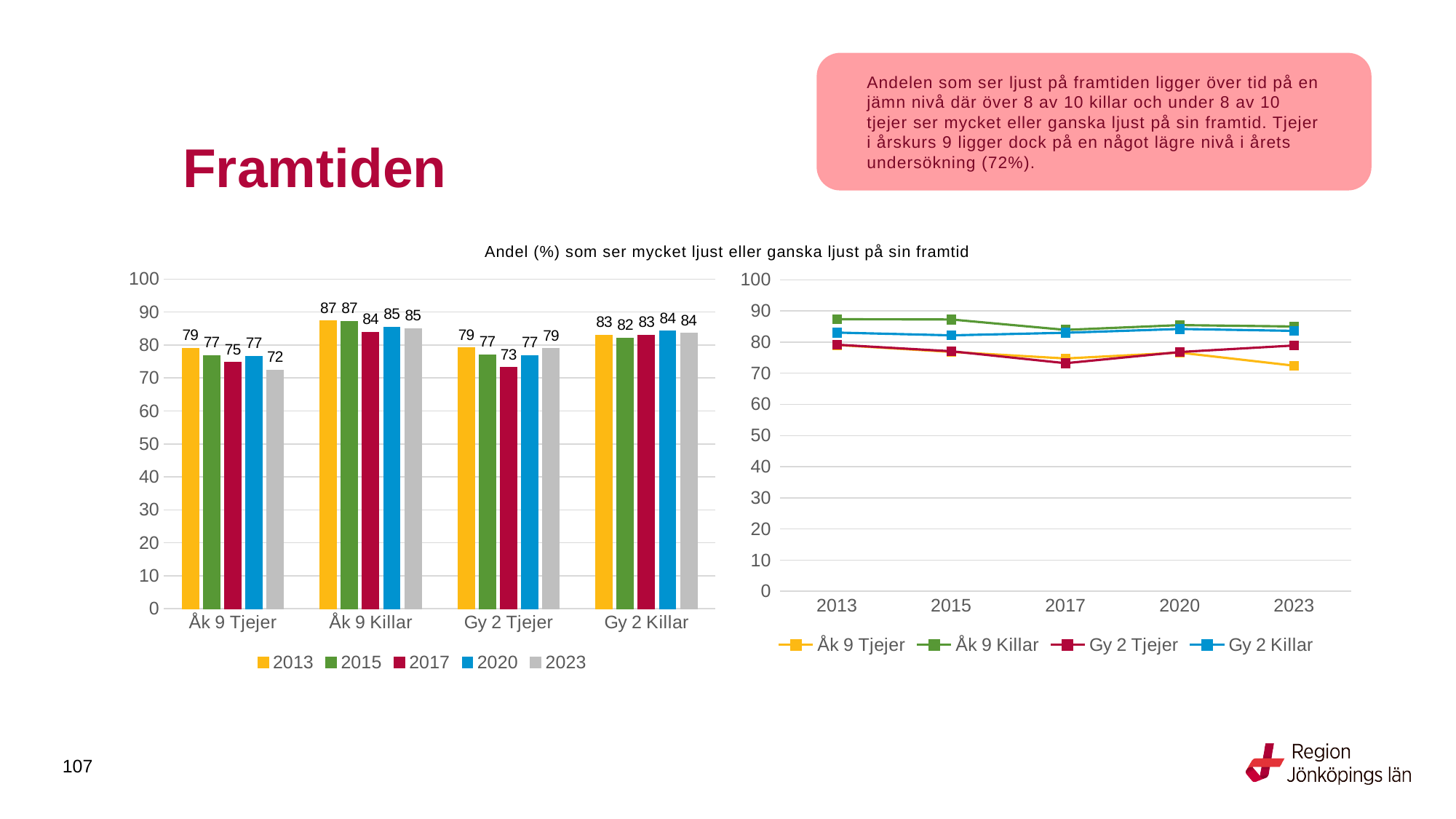
In the bar chart on the left, which is larger: the 2017 value for Åk 9 Killar or the 2017 value for Gy 2 Killar? Åk 9 Killar In the bar chart on the left, what is the difference between the 2013 and 2023 values for Åk 9 Tjejer? 7 What kind of chart is the chart on the right of the slide? Line chart In the bar chart on the left, what is the value for Åk 9 Killar in 2013? 87 How many categories are shown on the x axis of the bar chart on the left? 4 In the line chart on the right, how many series does the legend list? 4 How many series does the legend of the bar chart on the left list? 5 In the bar chart on the left, what is the value for Åk 9 Tjejer in 2023? 72 In the bar chart on the left, which category has the lowest value in 2023? Åk 9 Tjejer In the bar chart on the left, which category has the highest value in 2020? Åk 9 Killar In the line chart on the right, is the value for Åk 9 Killar in 2013 greater or less than 80? greater In the bar chart on the left, what is the value for Gy 2 Tjejer in 2017? 73